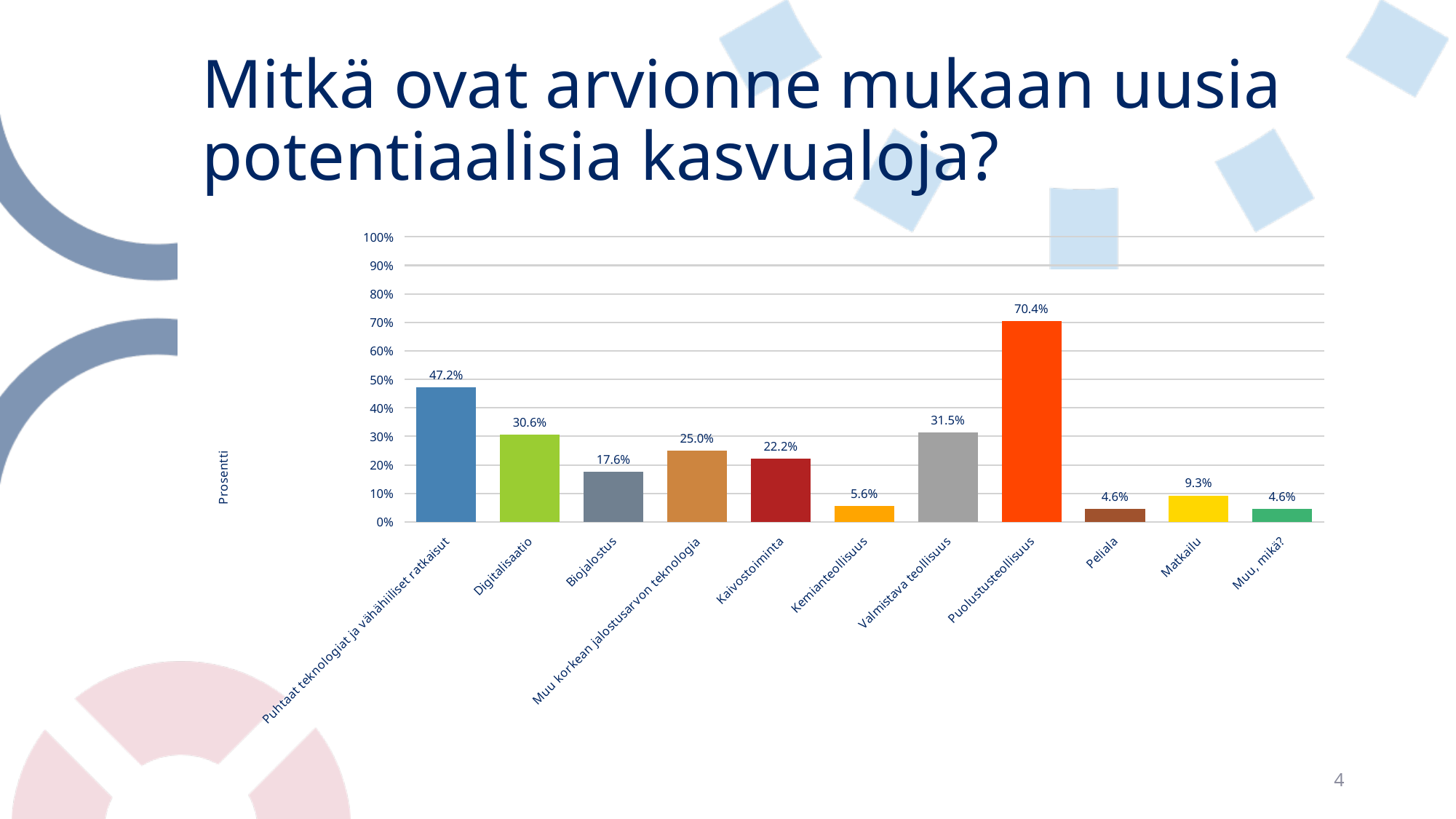
What is the value for Digitalisaatio? 30.6% What is the difference between the values for Valmistava teollisuus and Digitalisaatio? 0.9% Which category has the highest value? Puolustusteollisuus What is the difference between the values for Puolustusteollisuus and Puhtaat teknologiat ja vähähiiliset ratkaisut? 23.2% What is the label on the vertical axis? Prosentti What is the value for Kaivostoiminta? 22.2% Which is larger, the value for Biojalostus or the value for Muu korkean jalostusarvon teknologia? Muu korkean jalostusarvon teknologia What is the value for Puolustusteollisuus? 70.4% Is the value for Kemianteollisuus greater or less than 10%? less What is the value for Matkailu? 9.3% What kind of chart is shown on the slide? bar chart How many categories are shown on the x axis? 11